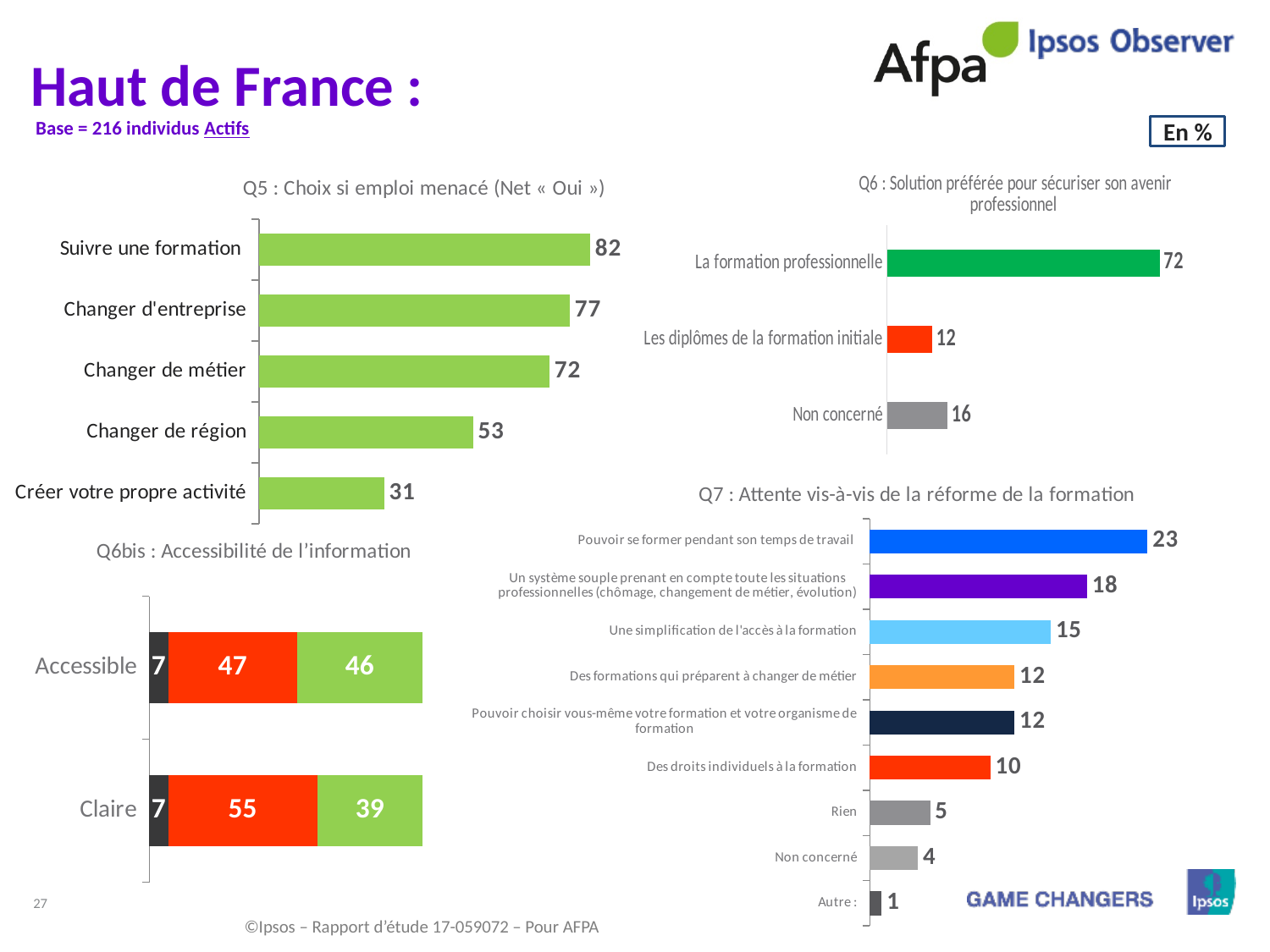
What kind of chart is the Q5 chart (Choix si emploi menacé)? Bar chart In the Q6 chart (Solution préférée pour sécuriser son avenir professionnel), which category has the highest value? La formation professionnelle In the Q7 chart (Attente vis-à-vis de la réforme de la formation), how many categories are shown? 9 In the Q5 chart (Choix si emploi menacé), how many categories are shown? 5 In the Q7 chart (Attente vis-à-vis de la réforme de la formation), which is larger: "Des droits individuels à la formation" or "Rien"? Des droits individuels à la formation In the Q5 chart (Choix si emploi menacé), what is the value for "Suivre une formation"? 82 In the Q6bis chart (Accessibilité de l'information), what is the total of the stacked bar for "Claire"? 101 In the Q5 chart (Choix si emploi menacé), what is the difference between "Changer d'entreprise" and "Changer de région"? 24 In the Q6 chart (Solution préférée pour sécuriser son avenir professionnel), what is the value for "Non concerné"? 16 In the Q6bis chart (Accessibilité de l'information), what is the value of the middle (red) segment for "Accessible"? 47 In the Q5 chart (Choix si emploi menacé), which category has the lowest value? Créer votre propre activité In the Q7 chart (Attente vis-à-vis de la réforme de la formation), what is the value for "Une simplification de l'accès à la formation"? 15